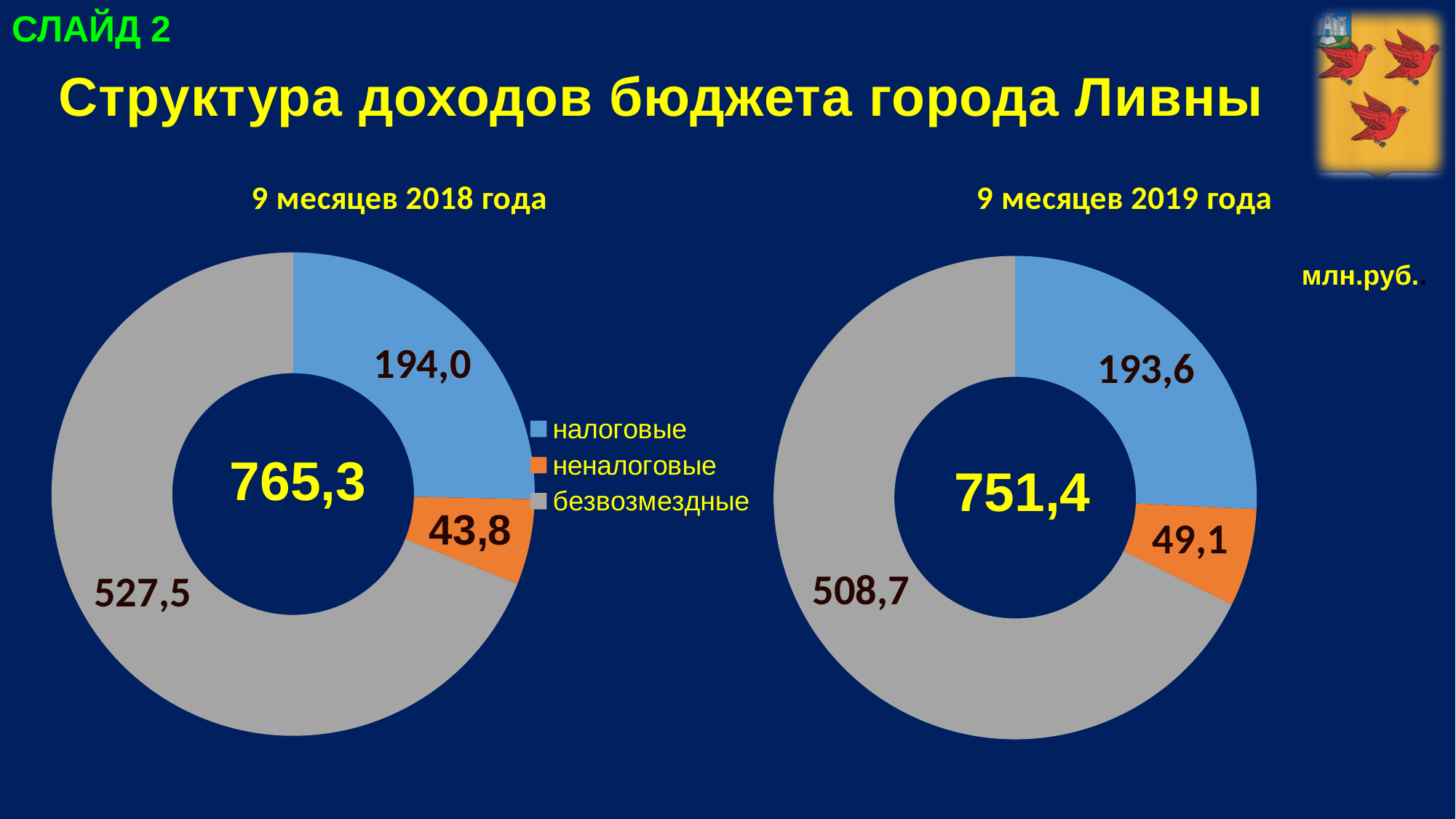
What colour represents неналоговые in the legend? Orange How many categories does the chart for 9 месяцев 2018 года show? 3 On the chart for 9 месяцев 2018 года, what is the value for налоговые? 194,0 On the chart for 9 месяцев 2018 года, what is the difference between безвозмездные and налоговые? 333,5 What is the difference between the неналоговые value for 9 месяцев 2019 года and for 9 месяцев 2018 года? 5,3 On the chart for 9 месяцев 2018 года, which category has the largest value? безвозмездные On the chart for 9 месяцев 2019 года, which category has the smallest value? неналоговые On the chart for 9 месяцев 2019 года, what is the value for безвозмездные? 508,7 What kind of chart is used for 9 месяцев 2018 года? Donut (pie) chart On the chart for 9 месяцев 2019 года, what is the value for неналоговые? 49,1 What is the total shown in the centre of the chart for 9 месяцев 2019 года? 751,4 Which is larger: безвозмездные for 9 месяцев 2018 года or безвозмездные for 9 месяцев 2019 года? 9 месяцев 2018 года